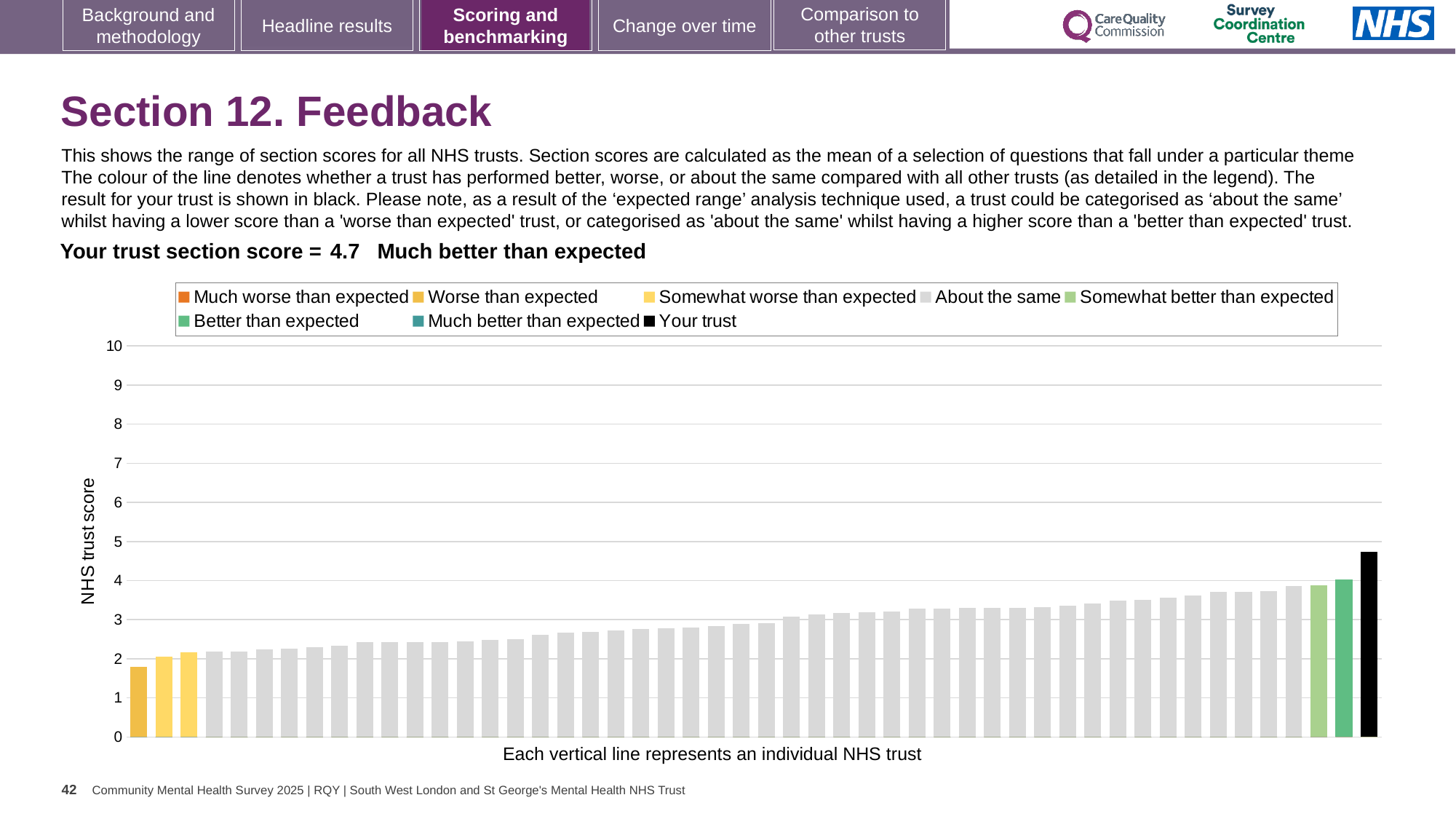
Which bar has the highest value in the chart? Your trust (the black bar) What is the label on the y axis of the chart? NHS trust score What is the maximum value shown on the y axis? 10 Is the value of the leftmost bar greater or less than 2? less Do the bar values rise or fall from left to right along the x axis? rise Which is larger, the value for your trust or the value of the leftmost bar? your trust What kind of chart is shown on the slide? bar chart How many entries does the chart legend list? 8 What is the section score for your trust shown on the slide? 4.7 Is the value for your trust greater or less than 4? greater What colour is the bar representing your trust? black How is your trust's section score categorised according to the slide? Much better than expected